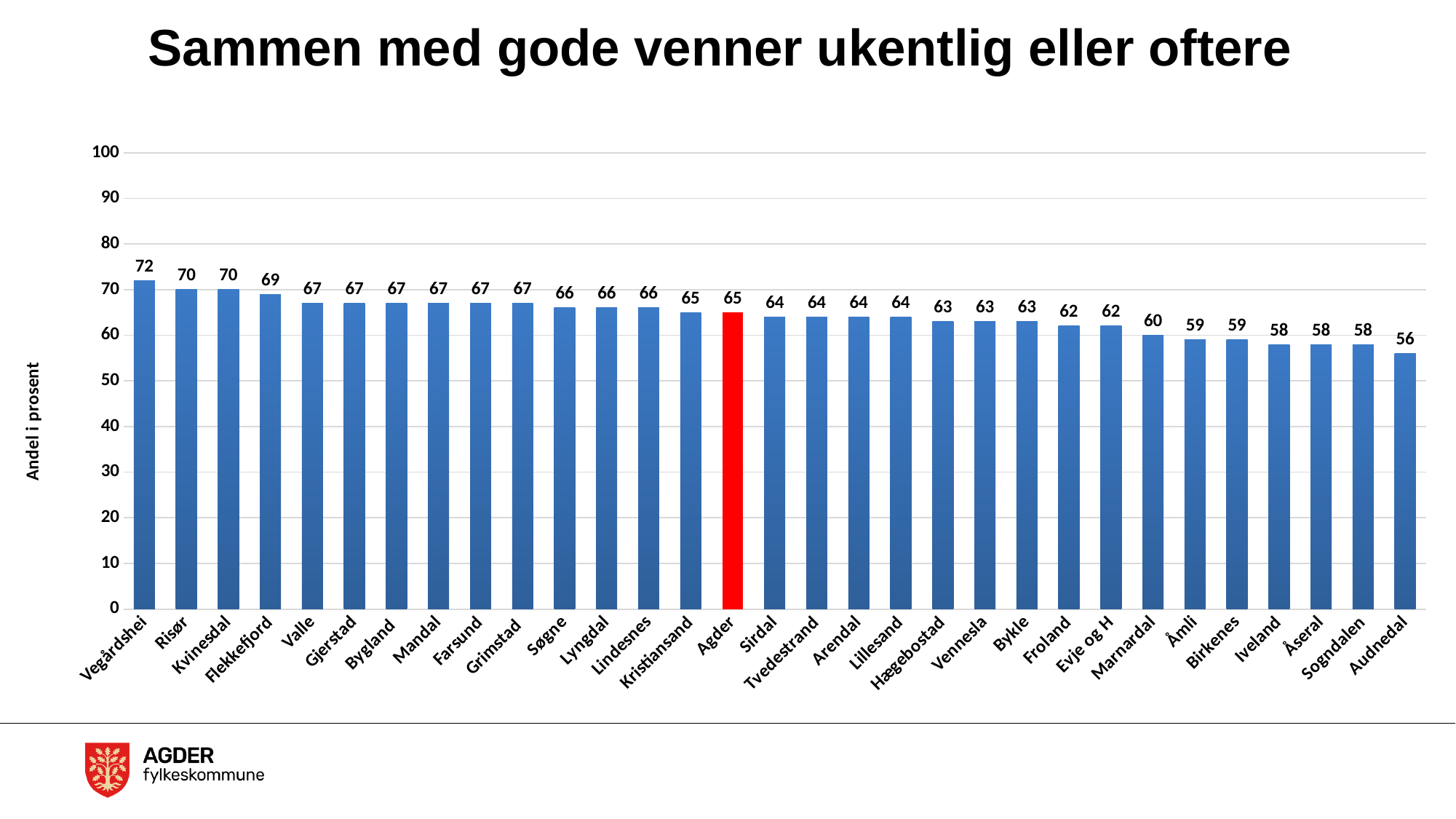
Which bar is coloured red instead of blue? Agder What is the value for Audnedal? 56 Which category has the highest value? Vegårdshei What is the difference between the values for Agder and Marnardal? 5 How many categories are shown on the x axis? 31 What kind of chart is shown on the slide? Bar chart What is the difference between the values for Vegårdshei and Audnedal? 16 Which category has the lowest value? Audnedal What is the value for Vegårdshei? 72 What is the value for Marnardal? 60 What is the value for Agder? 65 Which is larger, the value for Flekkefjord or the value for Froland? Flekkefjord